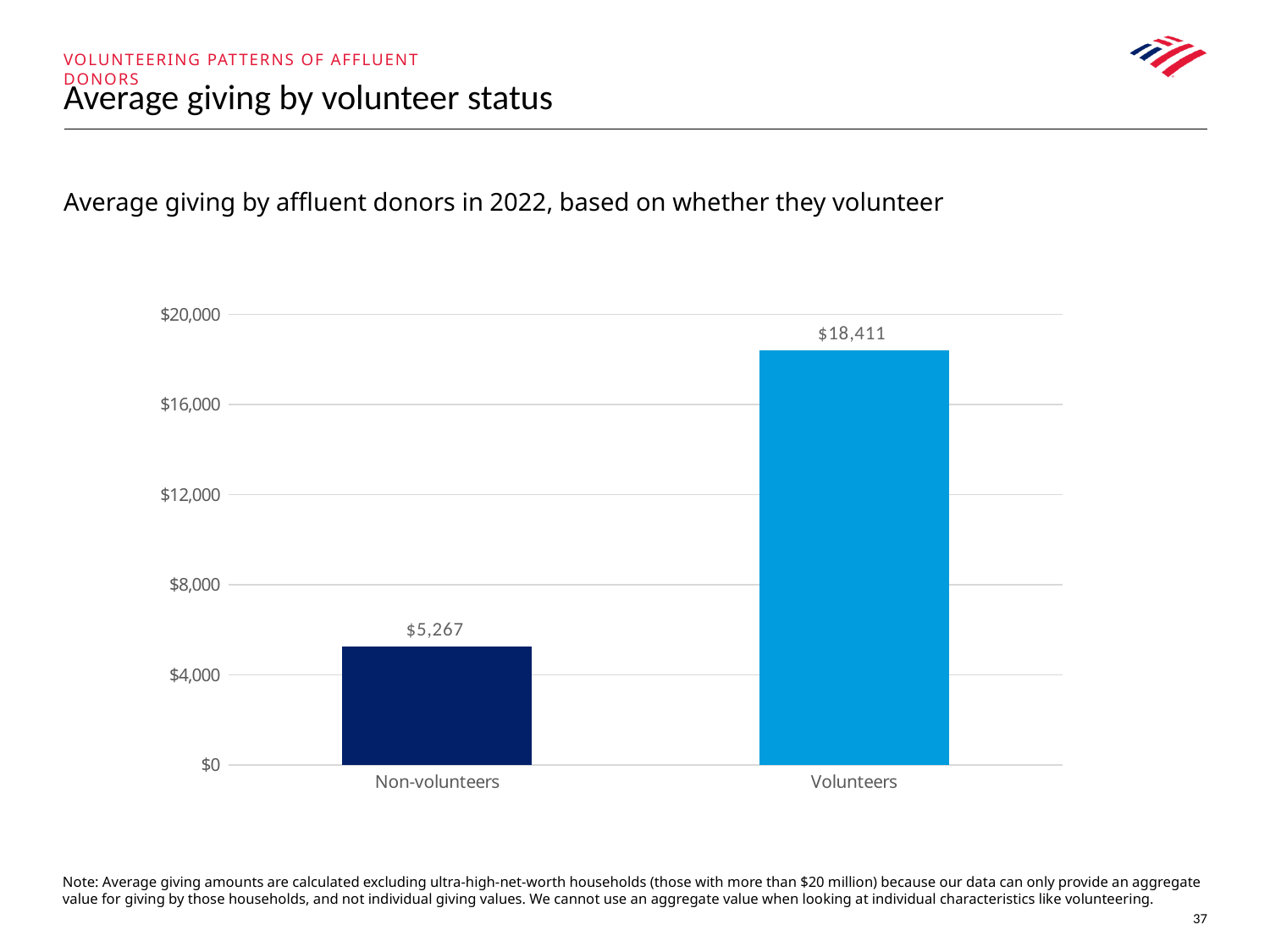
What is the title of the slide? Average giving by volunteer status How many categories are shown on the chart? 2 What is the difference in average giving between Volunteers and Non-volunteers? $13,144 Is the value for Volunteers greater or less than $16,000? greater What is the average giving for Non-volunteers? $5,267 What is the average giving for Volunteers? $18,411 Which is larger, the average giving for Volunteers or for Non-volunteers? Volunteers Which category has the highest average giving? Volunteers What is the highest value shown on the y axis? $20,000 Is the value for Non-volunteers greater or less than $8,000? less Which category has the lowest average giving? Non-volunteers What kind of chart is shown on the slide? bar chart